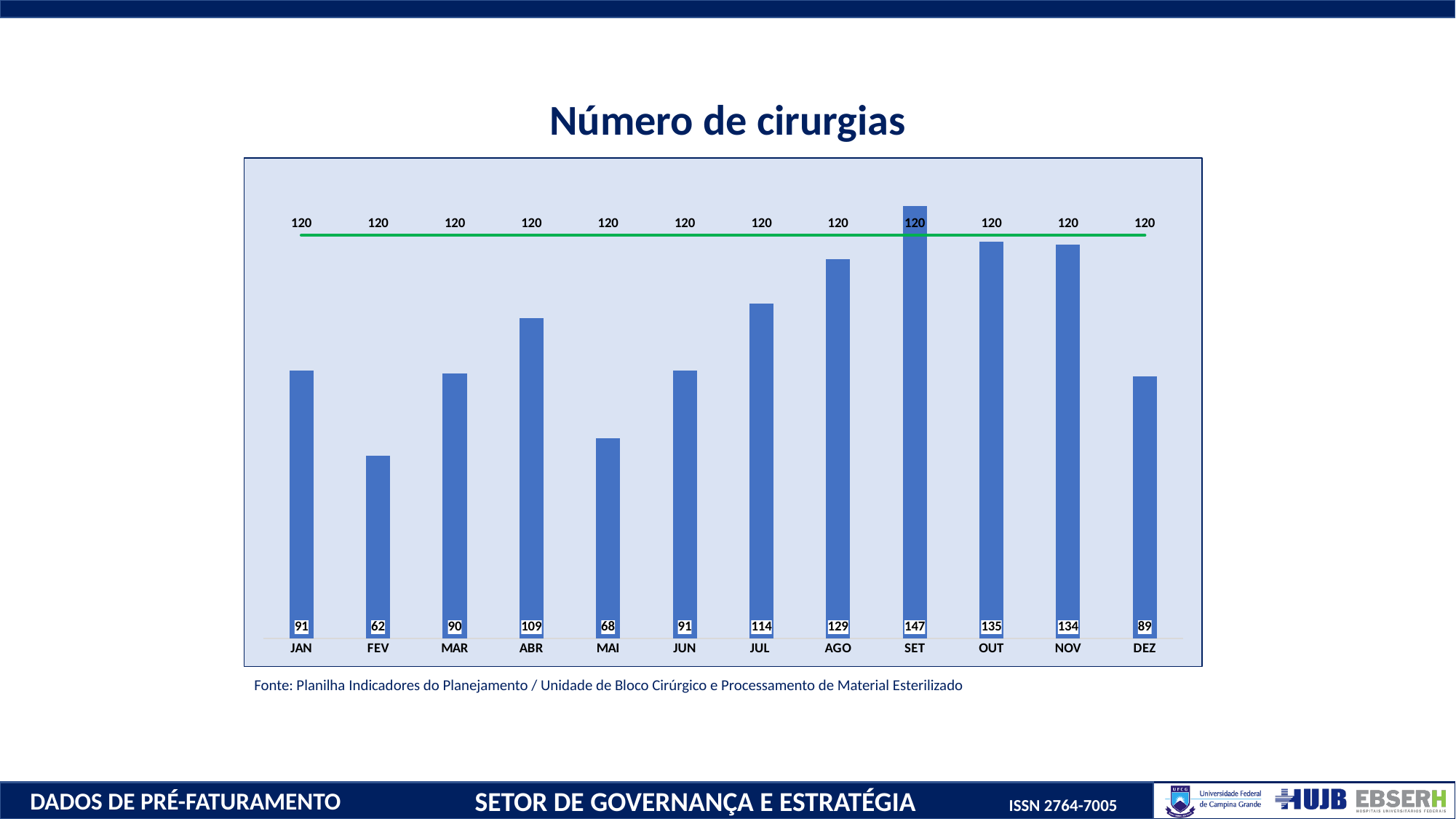
Which month has the highest number of surgeries? SET What is the difference between the values for OUT and NOV? 1 What is the value of the bar for FEV? 62 What is the difference between the values for SET and FEV? 85 What is the title of the chart? Número de cirurgias What is the number of surgeries shown for SET? 147 Is the value for AGO greater or less than the 120 target line? greater Which month has the lowest number of surgeries? FEV Which is larger, the value for ABR or the value for MAI? ABR What kind of chart is shown on the slide? bar chart How many months are shown on the x axis? 12 What is the value of the bar for JUL? 114